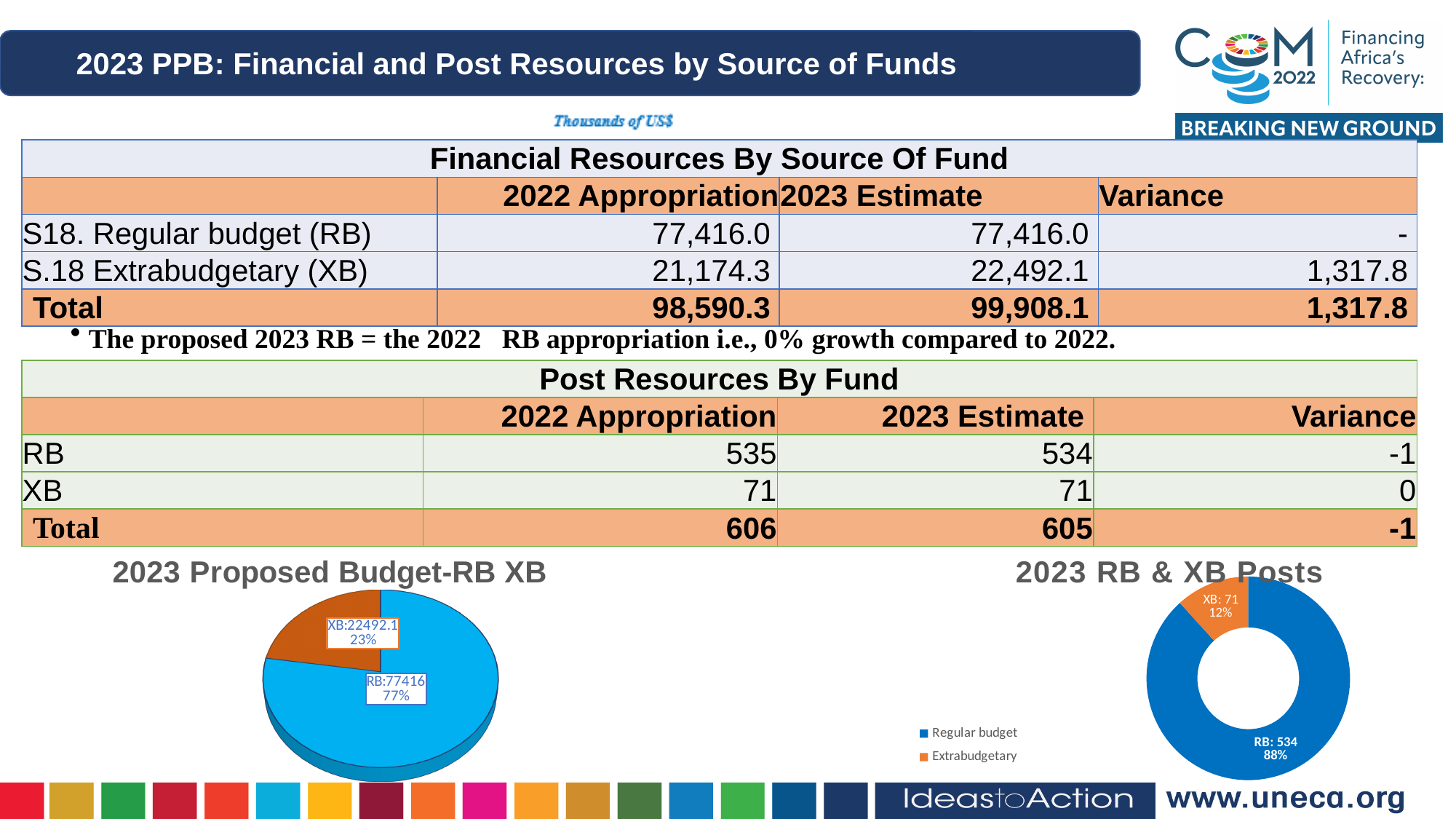
How many entries does the legend of the '2023 RB & XB Posts' chart list? 2 What kind of chart is '2023 Proposed Budget-RB XB'? Pie chart In the '2023 Proposed Budget-RB XB' chart, what value is shown for RB? 77416 In the '2023 Proposed Budget-RB XB' chart, what percentage share does RB have? 77% In the '2023 RB & XB Posts' chart, what percentage share does XB have? 12% In the '2023 Proposed Budget-RB XB' chart, what percentage share does XB have? 23% What kind of chart is '2023 RB & XB Posts'? Doughnut chart In the '2023 RB & XB Posts' chart, what value is shown for XB? 71 In the '2023 Proposed Budget-RB XB' chart, which slice is larger, RB or XB? RB In the '2023 RB & XB Posts' chart, what value is shown for RB? 534 In the '2023 Proposed Budget-RB XB' chart, what value is shown for XB? 22492.1 In the '2023 RB & XB Posts' chart, what is the difference between the RB and XB values? 463